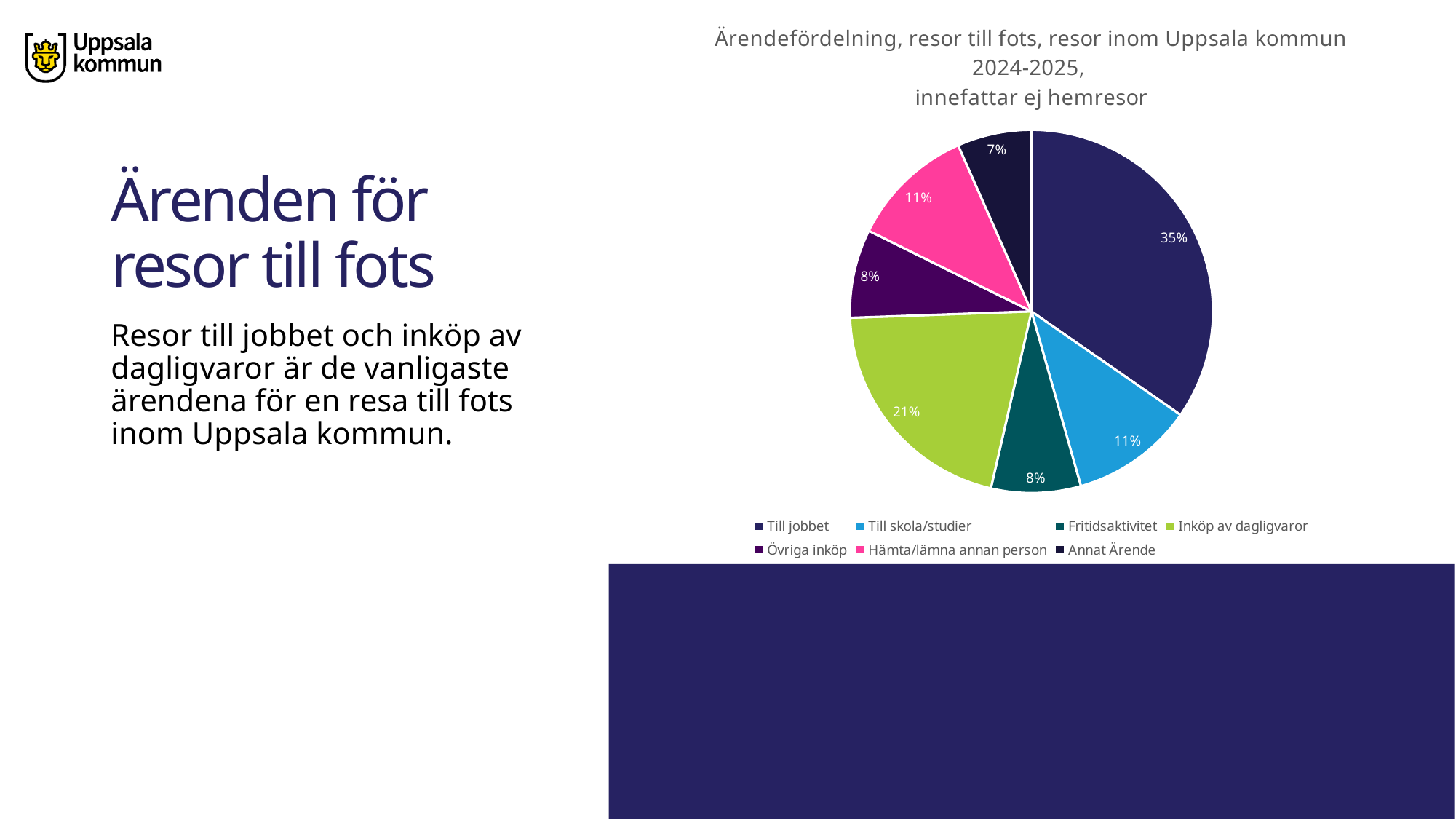
What is the title of the chart? Ärendefördelning, resor till fots, resor inom Uppsala kommun 2024-2025, innefattar ej hemresor Which category has the smallest slice of the pie? Annat Ärende What share of the pie does Till skola/studier have? 11% What share of the pie does Inköp av dagligvaror have? 21% How many categories does the legend list? 7 Which category has the largest slice of the pie? Till jobbet What share of the pie does Fritidsaktivitet have? 8% What kind of chart is shown on the slide? pie chart What is the difference in percentage points between Till jobbet and Inköp av dagligvaror? 14 Which is larger, the slice for Hämta/lämna annan person or the slice for Övriga inköp? Hämta/lämna annan person